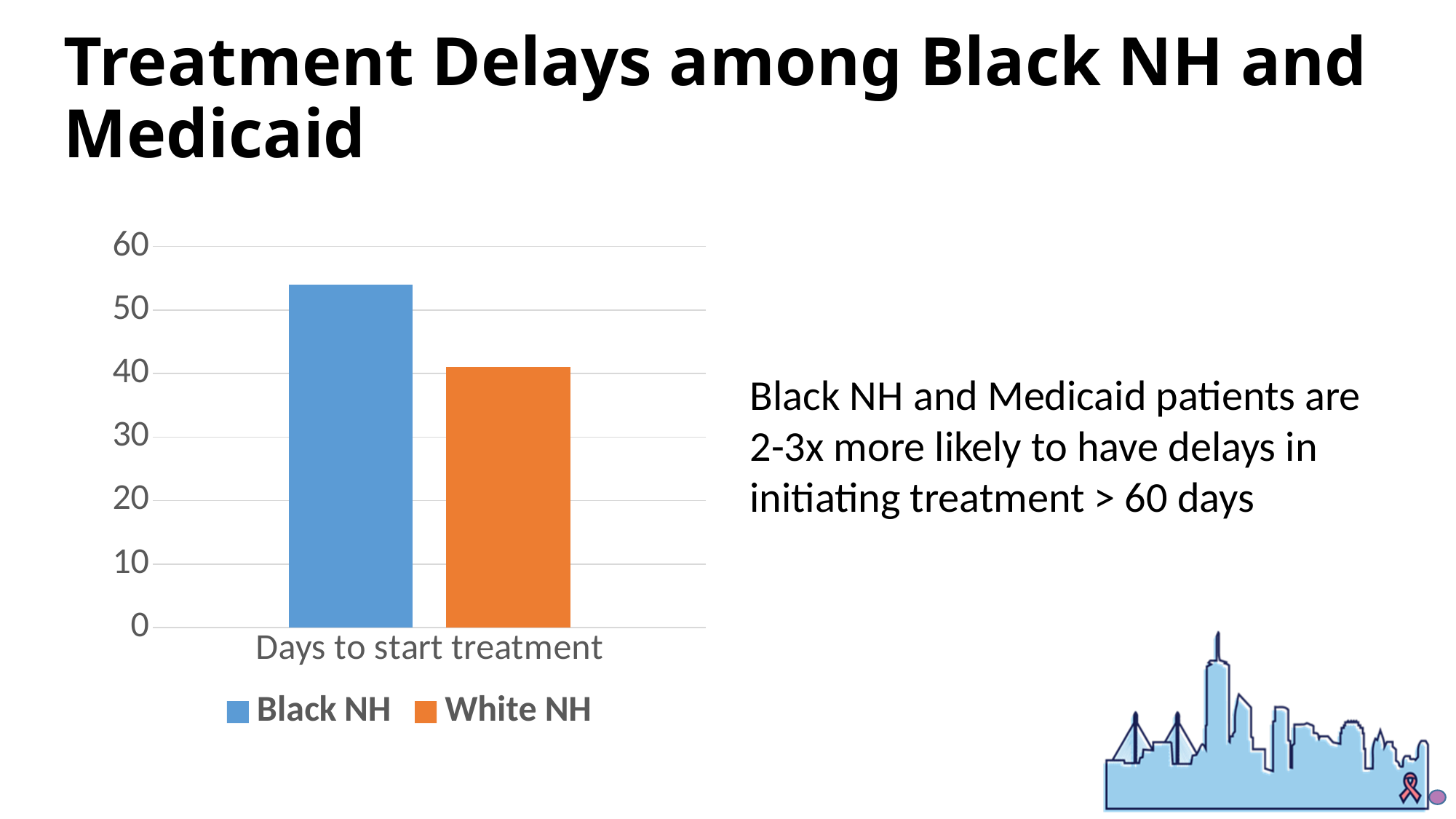
Is the value for White NH greater or less than 30? greater How many categories are shown on the x axis of the chart? 1 Which series has the lowest bar in the chart? White NH What kind of chart is shown on the slide? bar chart What is the category label shown on the x axis of the chart? Days to start treatment Which series has the highest bar in the chart? Black NH Is the value for Black NH greater or less than 50? greater Is the value for White NH greater or less than 50? less Which series has the higher value for Days to start treatment, Black NH or White NH? Black NH What colour represents the White NH series in the chart? orange How many series does the chart's legend list? 2